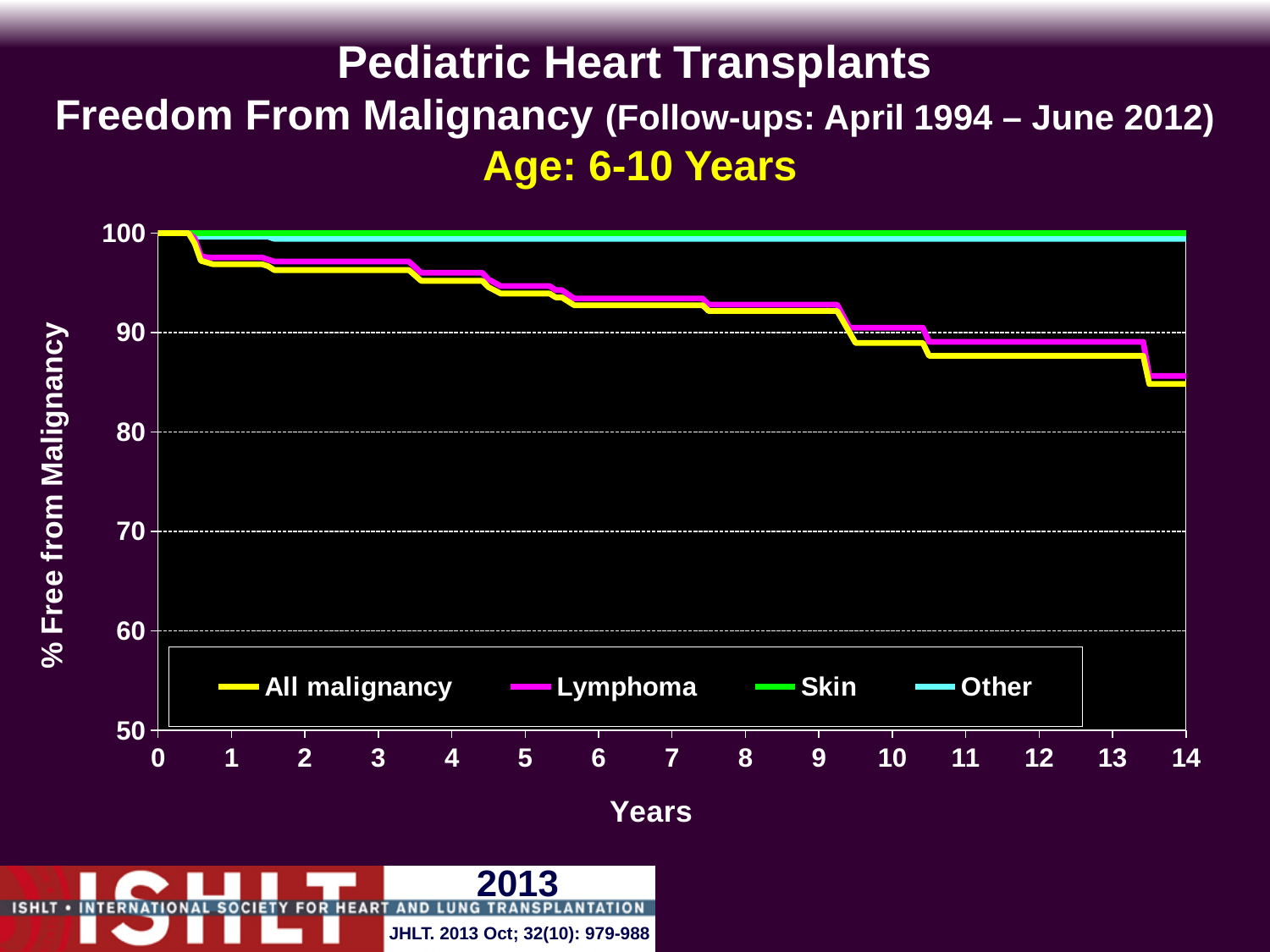
Is the value for All malignancy at 14 years greater or less than 90? less Does the All malignancy curve rise or fall as the years increase? fall What is the maximum value shown on the x axis (Years)? 14 What kind of chart is shown on the slide? line chart Which series are listed in the legend? All malignancy, Lymphoma, Skin, Other At 10 years, which is higher: Other or Lymphoma? Other Is the value for Skin at 14 years greater or less than 90? greater How many series does the legend list? 4 What is the title of the chart? Pediatric Heart Transplants Freedom From Malignancy (Follow-ups: April 1994 – June 2012) Age: 6-10 Years Is the value for All malignancy at 5 years greater or less than 90? greater At 14 years, which is higher: Skin or All malignancy? Skin